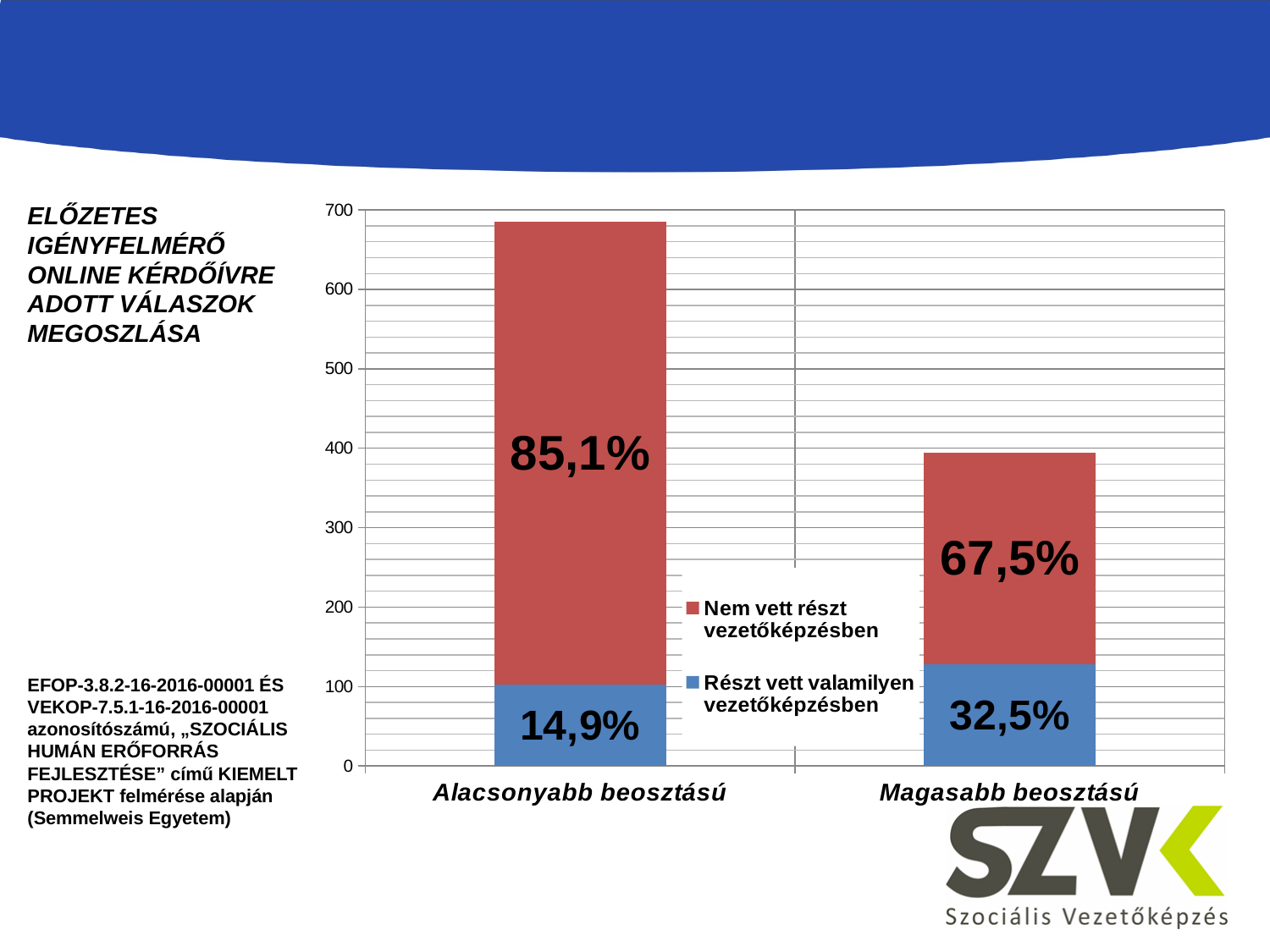
How many categories are shown on the x axis of the chart? 2 Which colour represents "Nem vett részt vezetőképzésben" in the chart? red Is the total height of the "Alacsonyabb beosztású" stacked bar greater or less than 600? greater What percentage label is shown for "Nem vett részt vezetőképzésben" in the "Alacsonyabb beosztású" bar? 85,1% What percentage label is shown for "Nem vett részt vezetőképzésben" in the "Magasabb beosztású" bar? 67,5% What percentage label is shown for "Részt vett valamilyen vezetőképzésben" in the "Alacsonyabb beosztású" bar? 14,9% What percentage label is shown for "Részt vett valamilyen vezetőképzésben" in the "Magasabb beosztású" bar? 32,5% What is the difference between the two percentage labels in the "Magasabb beosztású" bar? 35% What kind of chart is shown on the slide? stacked bar chart How many series does the chart legend list? 2 What is the difference between the two percentage labels in the "Alacsonyabb beosztású" bar? 70,2% Which category has the higher percentage for "Részt vett valamilyen vezetőképzésben"? Magasabb beosztású